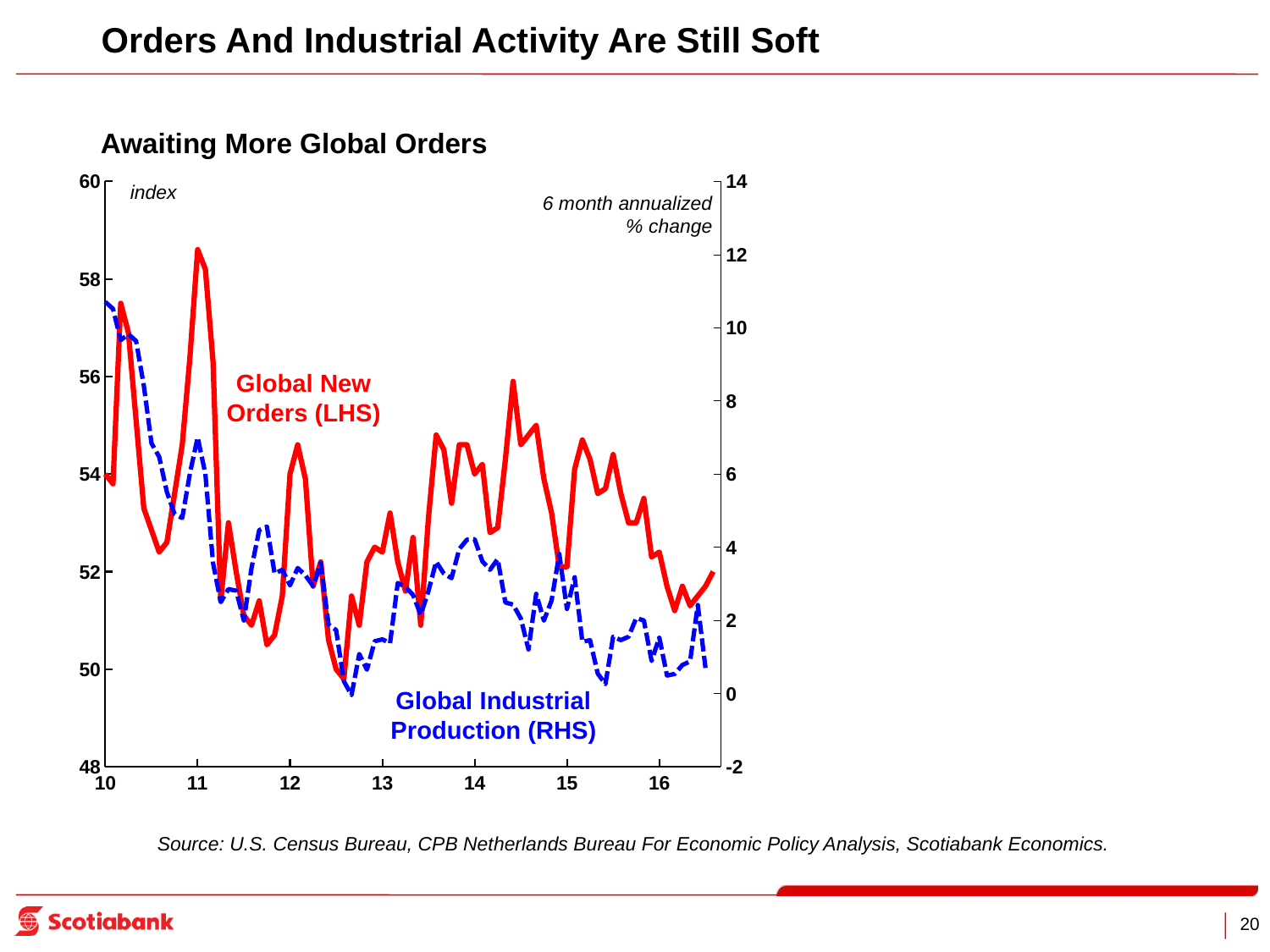
What is the title of the chart? Awaiting More Global Orders Is the peak value of Global New Orders in early 2011 greater or less than 58? greater How many series are plotted on the chart? 2 Is the value of Global Industrial Production at the start of 2010 greater or less than 10? greater Is the value of Global New Orders at the end of the series in 2016 greater or less than 54? less Does Global New Orders generally rise or fall between 2014 and 2016? fall Which series is plotted against the right-hand axis? Global Industrial Production (RHS) Does Global Industrial Production generally rise or fall from 2010 to 2016? fall What kind of chart is shown on the slide? line chart How many year labels are shown on the x axis? 7